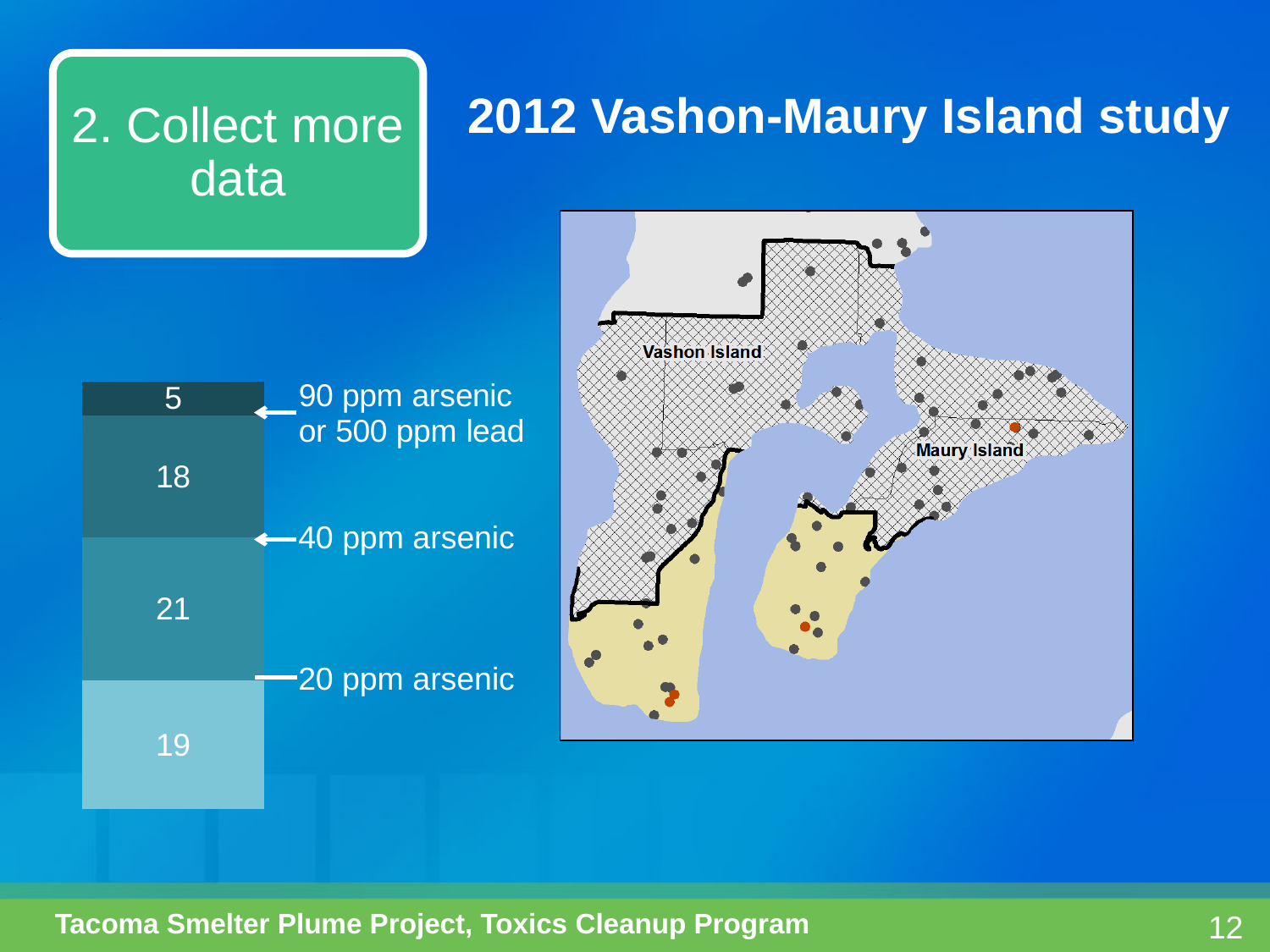
What is the value of the bottom (lightest) segment of the stacked bar? 19 What is the value of the segment directly above the '20 ppm arsenic' line in the stacked bar? 21 How many segments make up the stacked bar on the left of the slide? 4 What kind of chart is shown on the left of the slide? stacked bar chart What is the value of the segment between the '90 ppm arsenic or 500 ppm lead' line and the '40 ppm arsenic' line? 18 What is the difference between the largest segment (21) and the bottom segment (19) of the stacked bar? 2 What threshold label is attached to the boundary between the 18 and 21 segments of the stacked bar? 40 ppm arsenic Which is larger in the stacked bar: the top segment or the segment just below it? the segment just below it (18) What is the total of all segments in the stacked bar? 63 Which segment of the stacked bar has the largest value? 21 Which segment of the stacked bar has the smallest value? 5 What is the value of the topmost (darkest) segment of the stacked bar? 5